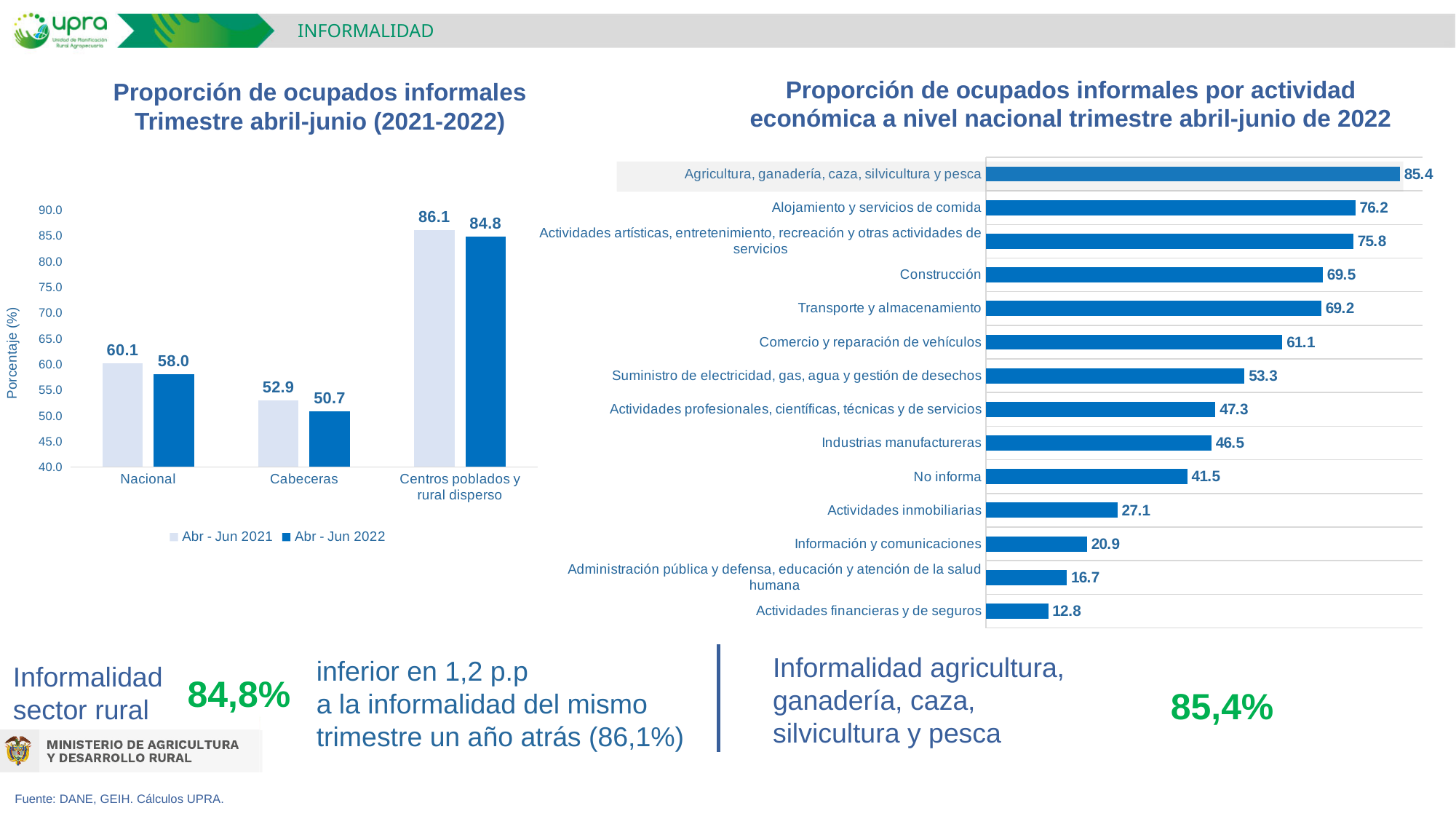
In the left chart 'Proporción de ocupados informales Trimestre abril-junio (2021-2022)', which category has the highest value in Abr - Jun 2022? Centros poblados y rural disperso In the left chart 'Proporción de ocupados informales Trimestre abril-junio (2021-2022)', what is the difference between the Abr - Jun 2021 and Abr - Jun 2022 values for Centros poblados y rural disperso? 1.3 In the left chart 'Proporción de ocupados informales Trimestre abril-junio (2021-2022)', what is the value for Cabeceras in Abr - Jun 2021? 52.9 In the left chart 'Proporción de ocupados informales Trimestre abril-junio (2021-2022)', what is the value for Nacional in Abr - Jun 2022? 58.0 In the right chart 'Proporción de ocupados informales por actividad económica', which activity has the highest value? Agricultura, ganadería, caza, silvicultura y pesca In the right chart 'Proporción de ocupados informales por actividad económica', which activity has the lowest value? Actividades financieras y de seguros In the right chart 'Proporción de ocupados informales por actividad económica', which is larger: Industrias manufactureras or Actividades inmobiliarias? Industrias manufactureras In the left chart 'Proporción de ocupados informales Trimestre abril-junio (2021-2022)', how many series does the legend list? 2 In the right chart 'Proporción de ocupados informales por actividad económica', what is the value for Construcción? 69.5 What kind of chart is the right chart 'Proporción de ocupados informales por actividad económica'? Bar chart In the left chart 'Proporción de ocupados informales Trimestre abril-junio (2021-2022)', what is the label on the vertical axis? Porcentaje (%) In the right chart 'Proporción de ocupados informales por actividad económica', how many activities are shown? 14